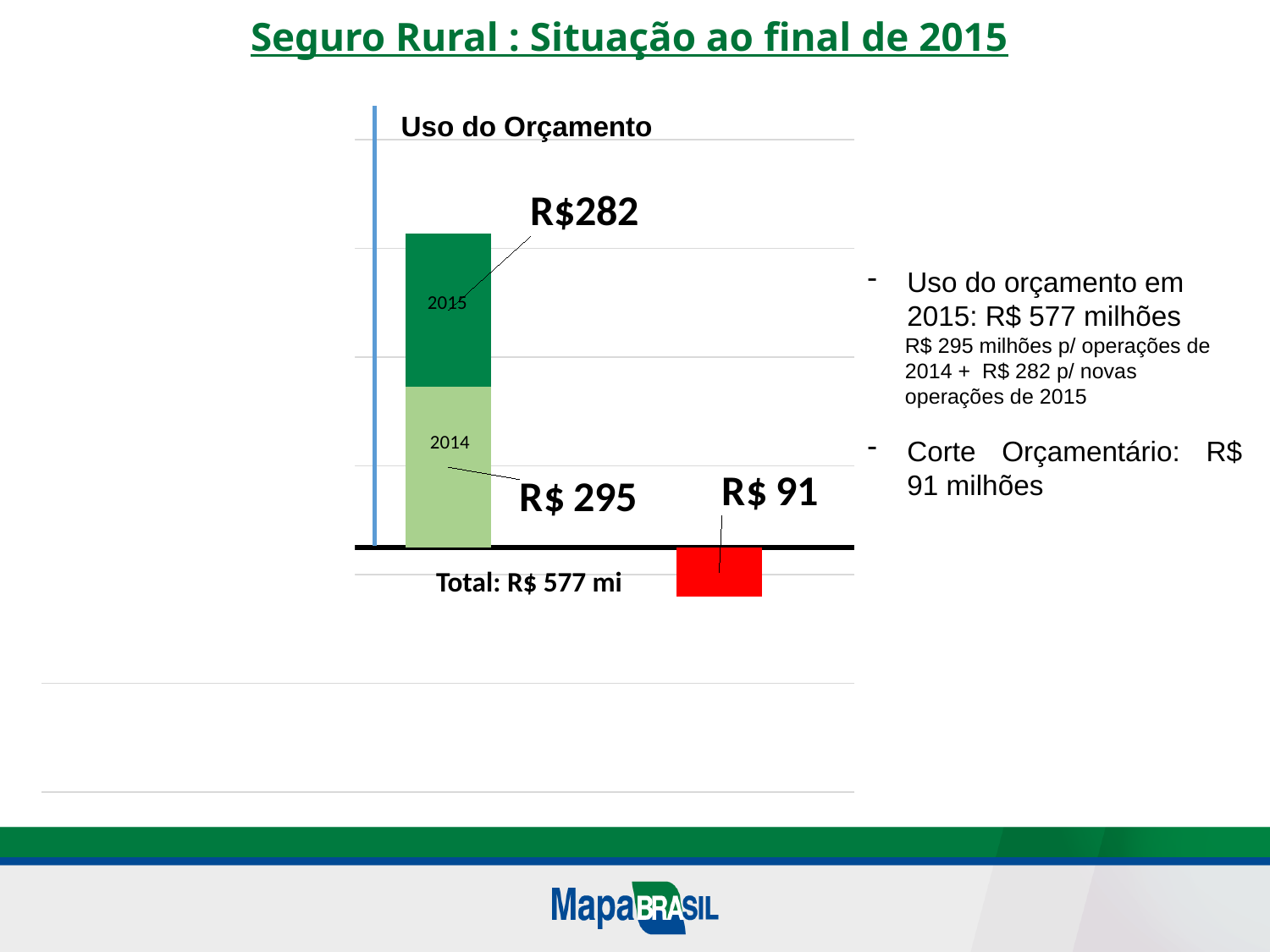
Which segment of the stacked bar is the largest? 2014 Which segment of the stacked bar is the smallest? 2015 What is the value of the 2015 segment of the stacked bar? R$282 What is the difference between the 2014 segment (R$ 295) and the 2015 segment (R$282)? R$ 13 What value is labelled on the red bar below the axis? R$ 91 What kind of chart is shown on the slide? bar chart How many segments make up the stacked bar? 2 What is the title of the chart? Uso do Orçamento Which segment of the stacked bar is larger, 2014 or 2015? 2014 What is the total of the stacked bar shown on the chart? R$ 577 mi What is the value of the 2014 segment of the stacked bar? R$ 295 What colour is the bar that extends below the axis? red